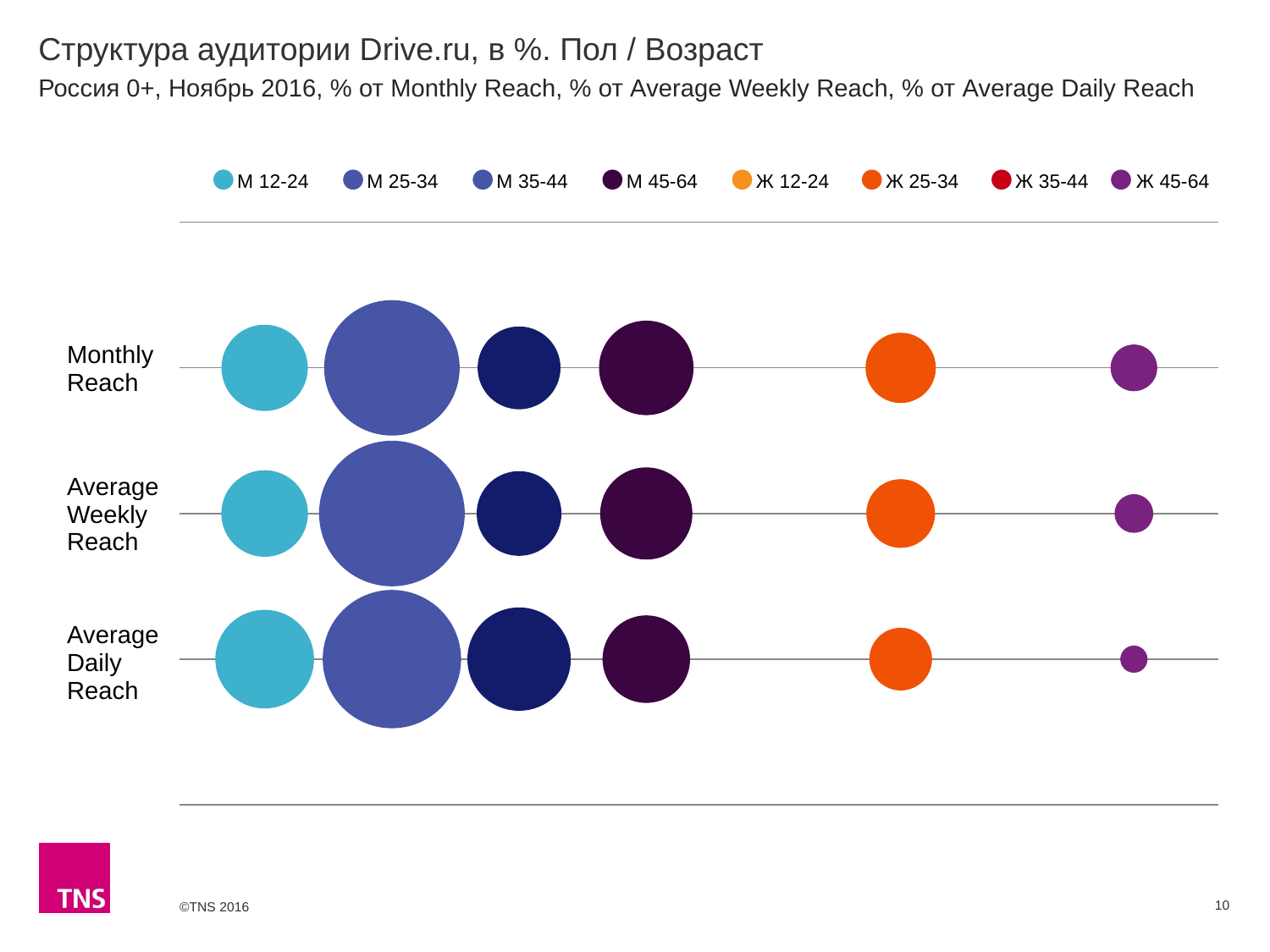
In the Monthly Reach row, which bubble is larger: М 45-64 or Ж 45-64? М 45-64 Does the bubble for Ж 45-64 get larger or smaller going from Monthly Reach to Average Daily Reach? Smaller Which audience group has the largest bubble in the Average Weekly Reach row? М 25-34 How many series does the legend list? 8 What is the title of the chart on the slide? Структура аудитории Drive.ru, в %. Пол / Возраст Does the bubble for М 35-44 get larger or smaller going from Monthly Reach to Average Daily Reach? Larger What kind of chart is shown on the slide? Bubble chart Which audience group has the smallest visible bubble in the Average Daily Reach row? Ж 45-64 Which audience group has the largest bubble in the Monthly Reach row? М 25-34 In the Average Daily Reach row, which bubble is larger: М 25-34 or Ж 45-64? М 25-34 How many reach categories (rows) are plotted on the chart? 3 Which month and year does the chart's subtitle refer to? Ноябрь 2016